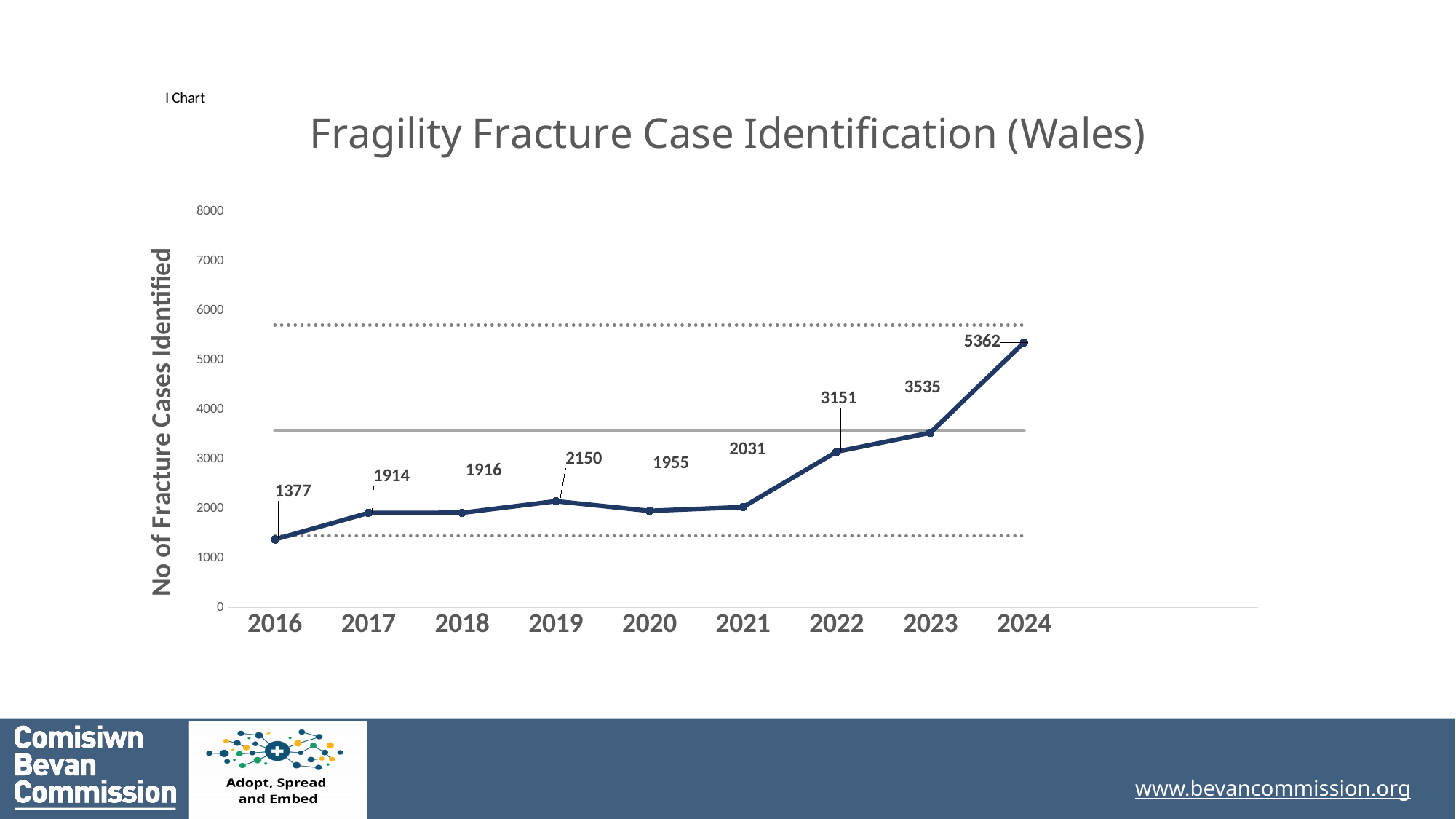
Which year had more fracture cases identified, 2019 or 2020? 2019 Which year has the lowest number of fracture cases identified? 2016 Which year has the highest number of fracture cases identified? 2024 What is the difference between the number of cases identified in 2024 and in 2023? 1827 Is the value for 2022 greater or less than 3000? greater What is the number of fracture cases identified in 2020? 1955 What is the number of fracture cases identified in 2024? 5362 What is the title of the chart? Fragility Fracture Case Identification (Wales) Do the values generally rise or fall from 2016 to 2024? Rise How many years are plotted on the x axis? 9 What is the number of fracture cases identified in 2016? 1377 What kind of chart is shown on the slide? Line chart